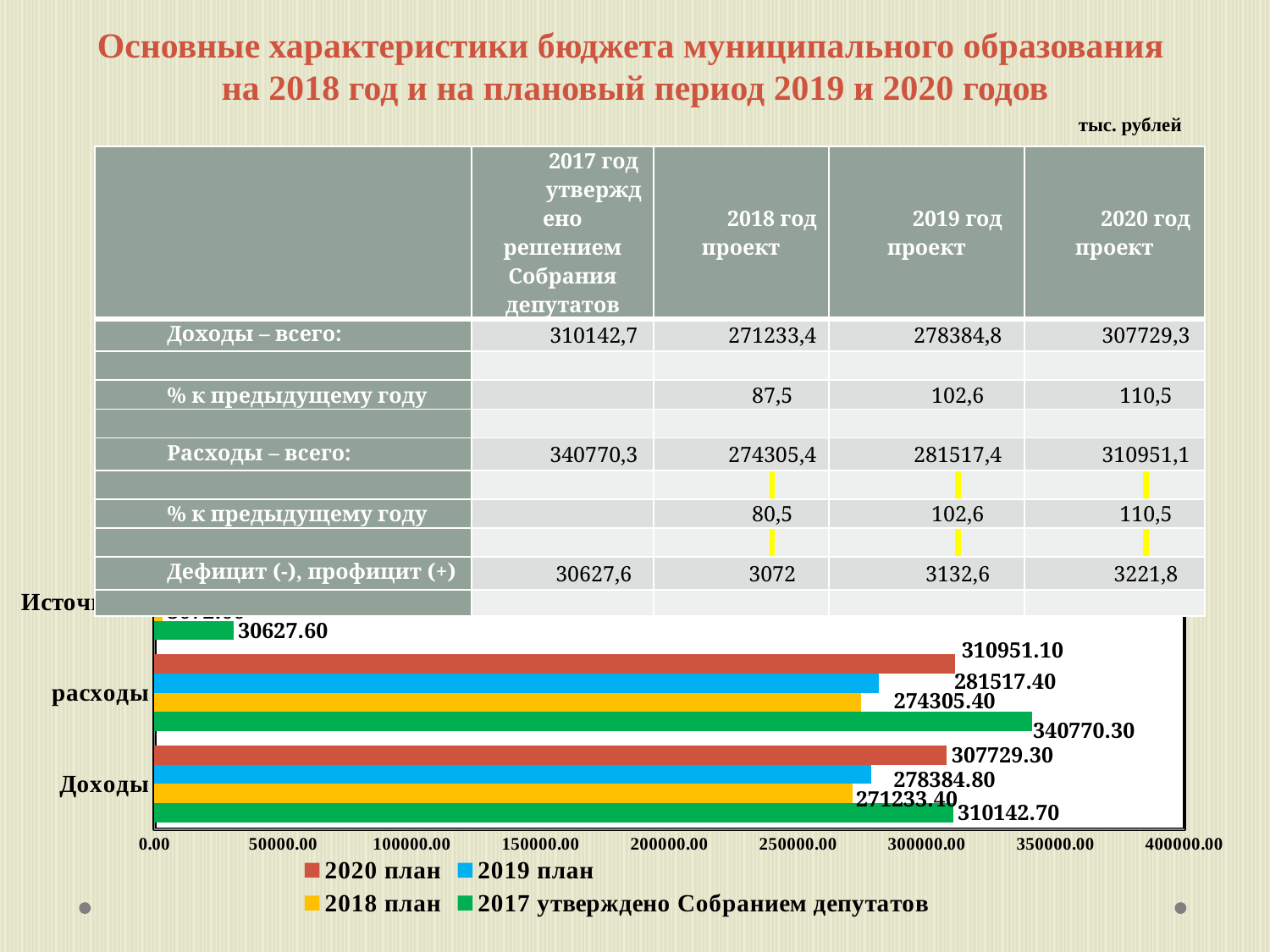
In the chart, what is the difference between the 2020 план values for расходы and Доходы? 3221.80 In the chart, what is the value for расходы in the 2019 план series? 281517.40 In the chart, what is the value for Доходы in the 2018 план series? 271233.40 In the chart, is the 2018 план value for расходы greater or less than 300000.00? less In the chart, is the 2019 план value for Доходы larger or smaller than the 2020 план value for Доходы? smaller Which colour represents the 2019 план series in the chart? blue In the chart, which series has the highest value for расходы? 2017 утверждено Собранием депутатов What kind of chart is shown at the bottom of the slide? bar chart In the chart, what is the value for Доходы in the 2020 план series? 307729.30 In the chart, which series has the lowest value for Доходы? 2018 план In the chart, what is the value for расходы in the 2017 утверждено Собранием депутатов series? 340770.30 How many series does the chart legend list? 4